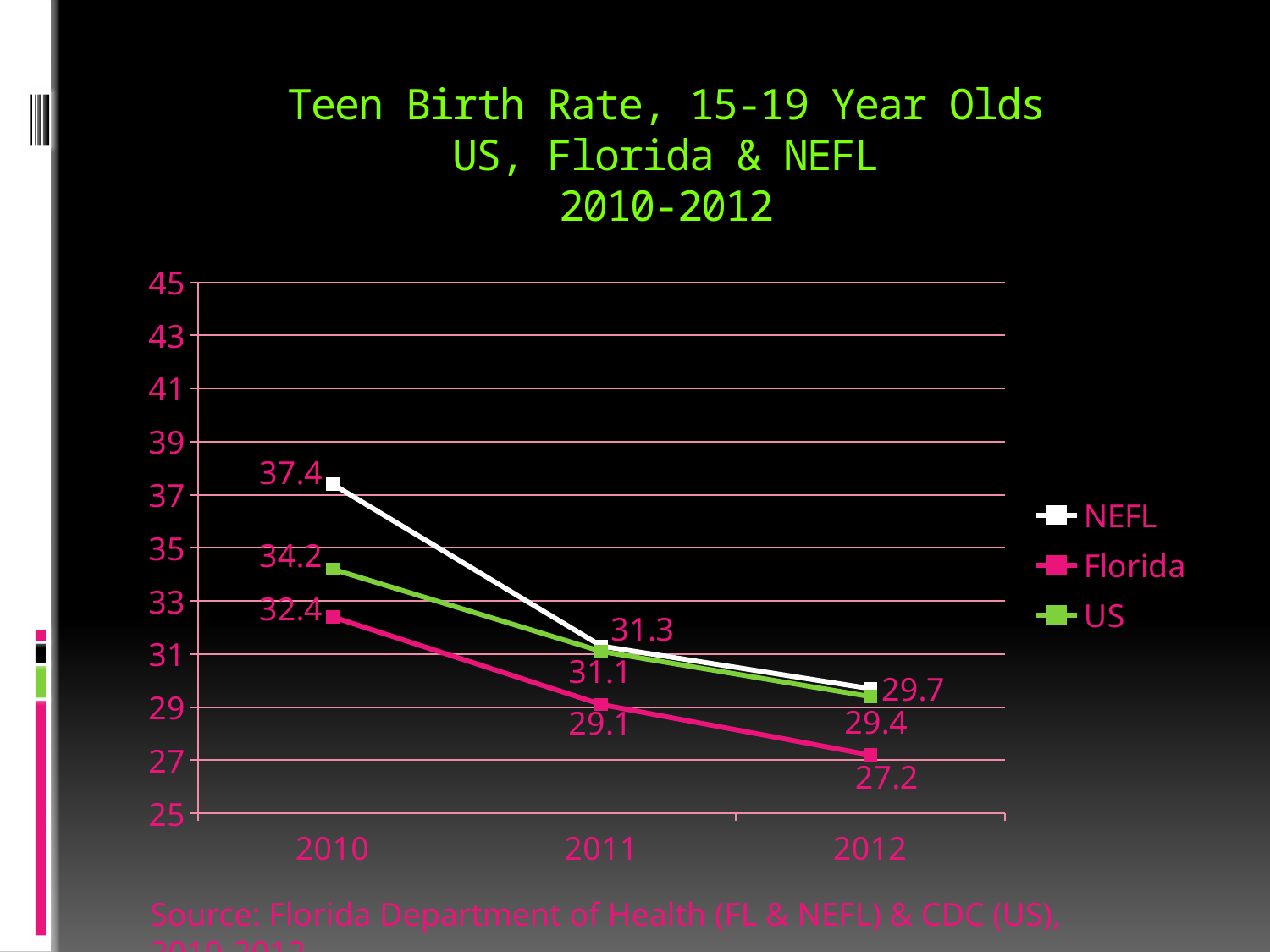
How many years are shown on the x axis? 3 Which series had the lowest value in 2012? Florida What was the US teen birth rate in 2011? 31.1 Do the NEFL values rise or fall from 2010 to 2012? fall What was the NEFL teen birth rate in 2010? 37.4 Which is larger, the Florida value in 2010 or the US value in 2012? Florida value in 2010 What is the difference between the US values in 2010 and 2012? 4.8 What was the Florida teen birth rate in 2012? 27.2 How many series does the legend list? 3 Which series had the highest value in 2010? NEFL What type of chart is shown on the slide? line chart What is the difference between the NEFL and Florida values in 2010? 5